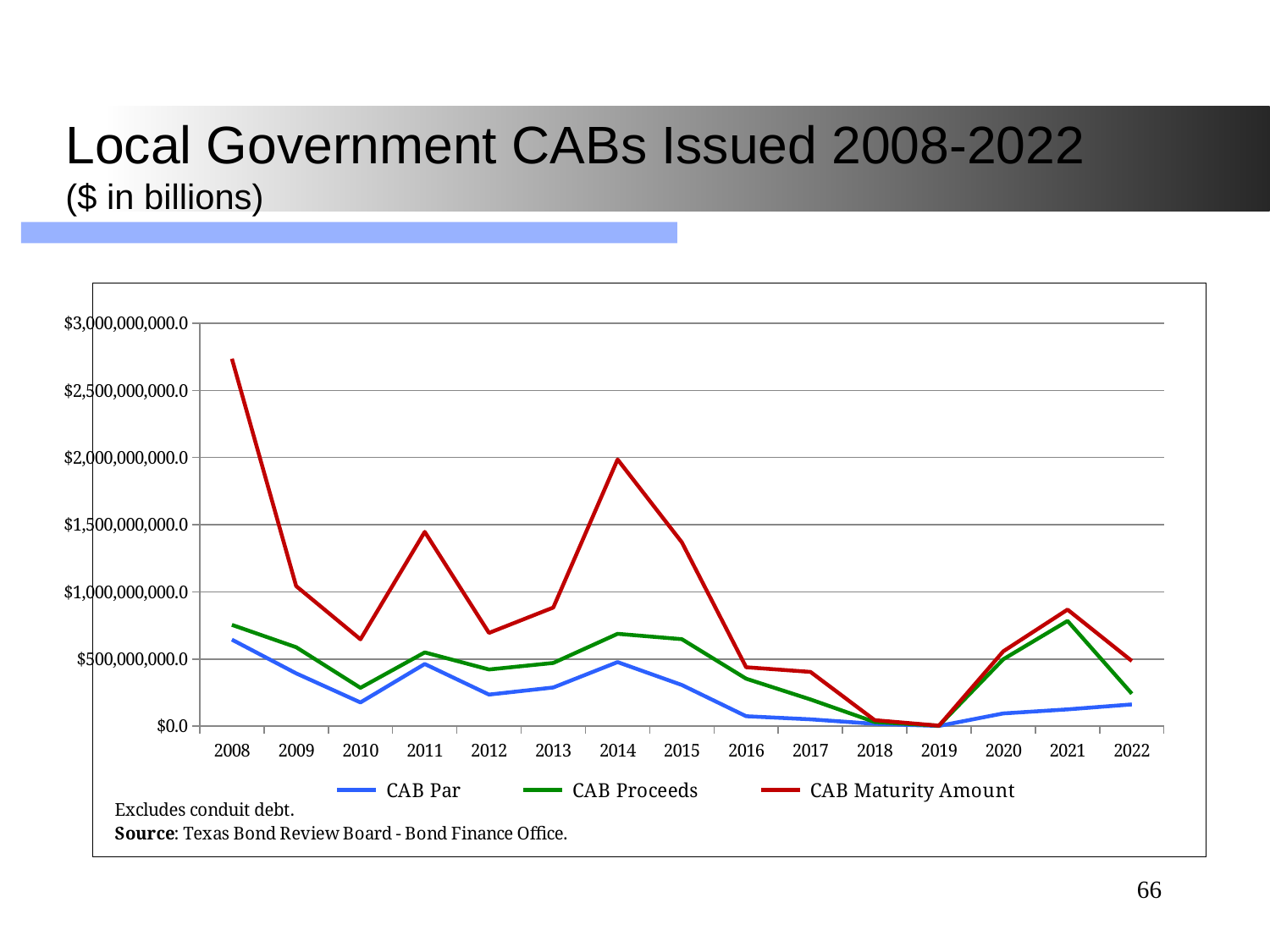
Does the CAB Maturity Amount rise or fall from 2014 to 2019? fall Is the CAB Par value for 2016 greater or less than $500,000,000.0? less Which is larger, the CAB Par value in 2014 or in 2016? 2014 What is the title of the chart on the slide? Local Government CABs Issued 2008-2022 ($ in billions) Which is larger, the CAB Maturity Amount in 2008 or in 2014? 2008 Is the CAB Proceeds value for 2021 greater or less than $500,000,000.0? greater Is the CAB Maturity Amount for 2008 greater or less than $2,500,000,000.0? greater What kind of chart is shown on the slide? line chart In which year is the CAB Maturity Amount highest? 2008 How many series does the legend list? 3 How many years are plotted along the x axis? 15